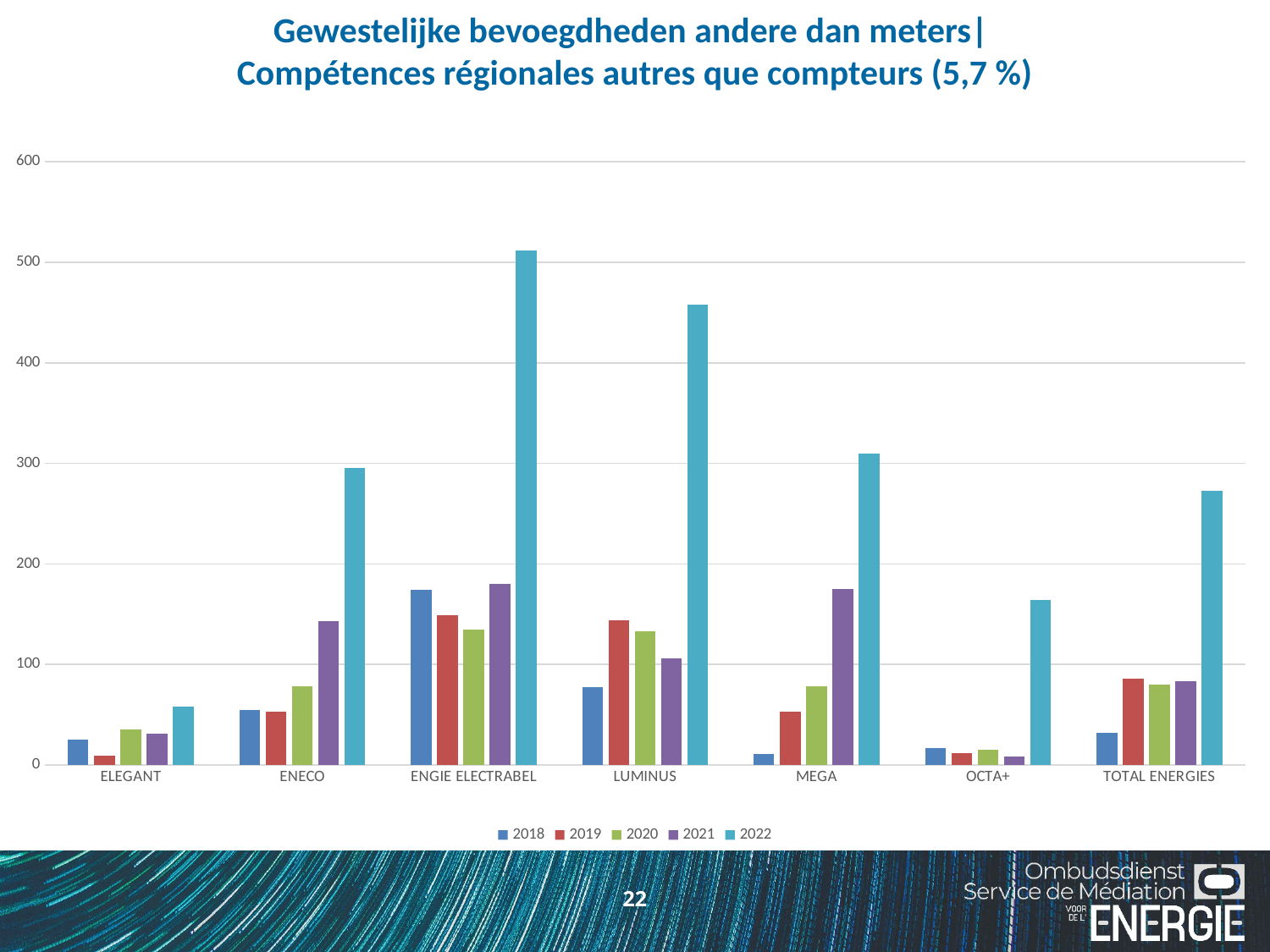
Which year is shown in the legend with the light blue colour? 2022 Is the 2022 value for OCTA+ greater or less than 100? greater How many supplier categories are shown on the x axis? 7 Is the 2022 value for ENGIE ELECTRABEL greater or less than 400? greater Which supplier has the lowest value for 2022? ELEGANT Is the 2022 value for ENECO greater or less than 200? greater What kind of chart is shown on the slide? Bar chart Which supplier has the highest value for 2022? ENGIE ELECTRABEL Which is larger, the 2022 value for MEGA or the 2022 value for TOTAL ENERGIES? MEGA Do the values for ENECO rise or fall from 2018 to 2022? rise How many series does the legend list? 5